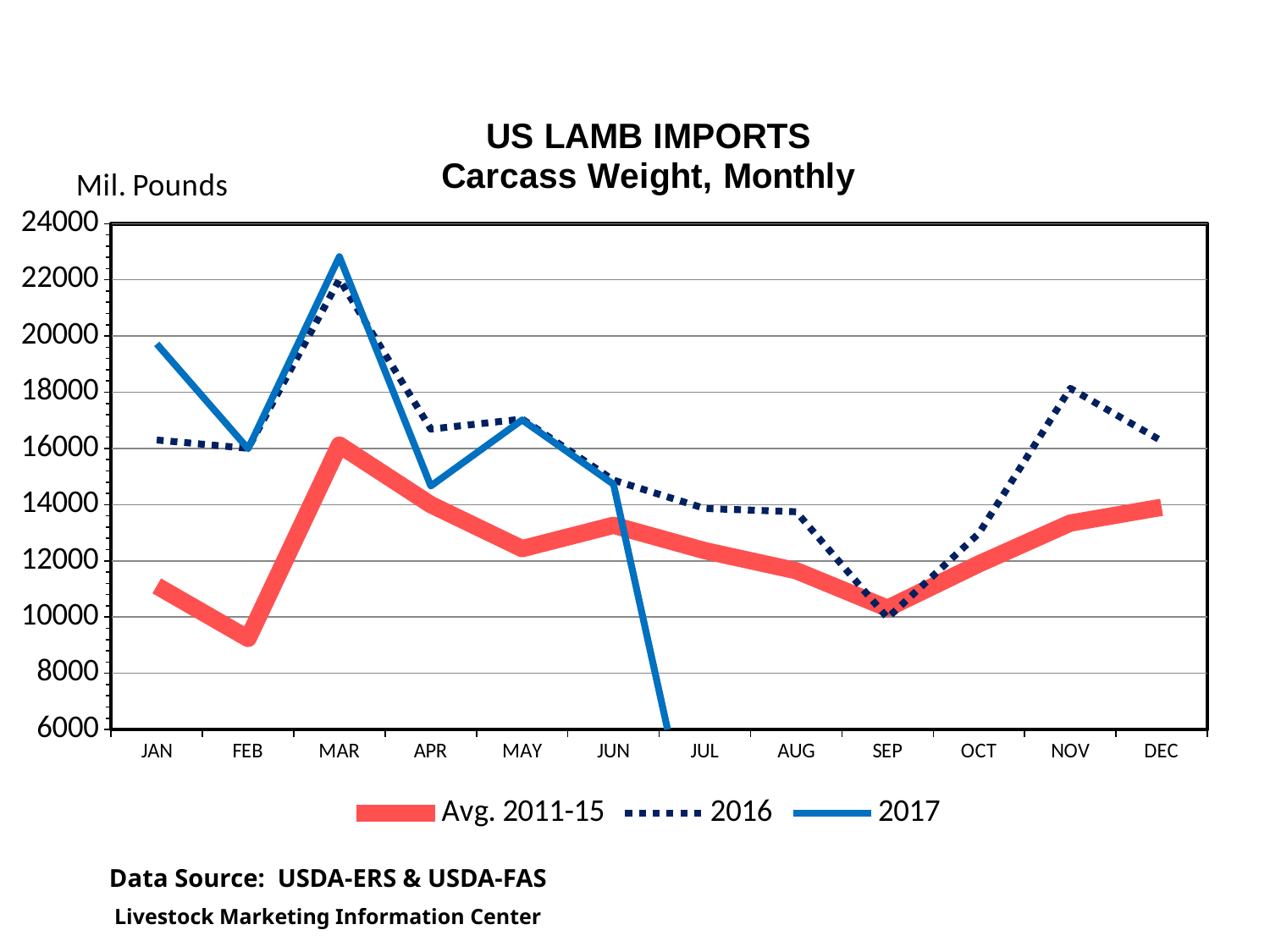
How many series does the legend list? 3 What kind of chart is shown on the slide? line chart What unit label is shown above the y axis? Mil. Pounds Is the Avg. 2011-15 value for FEB greater or less than 10000? less In which month is the Avg. 2011-15 line at its lowest? FEB Is the 2017 value for MAR greater or less than 22000? greater In JAN, which series has the higher value, 2016 or 2017? 2017 How many months are shown on the x axis? 12 In which month does the 2016 line reach its highest value? MAR In which month does the 2017 line reach its highest value? MAR Does the 2016 line rise or fall from SEP to NOV? rise Is the 2017 value for JAN greater or less than 20000? less